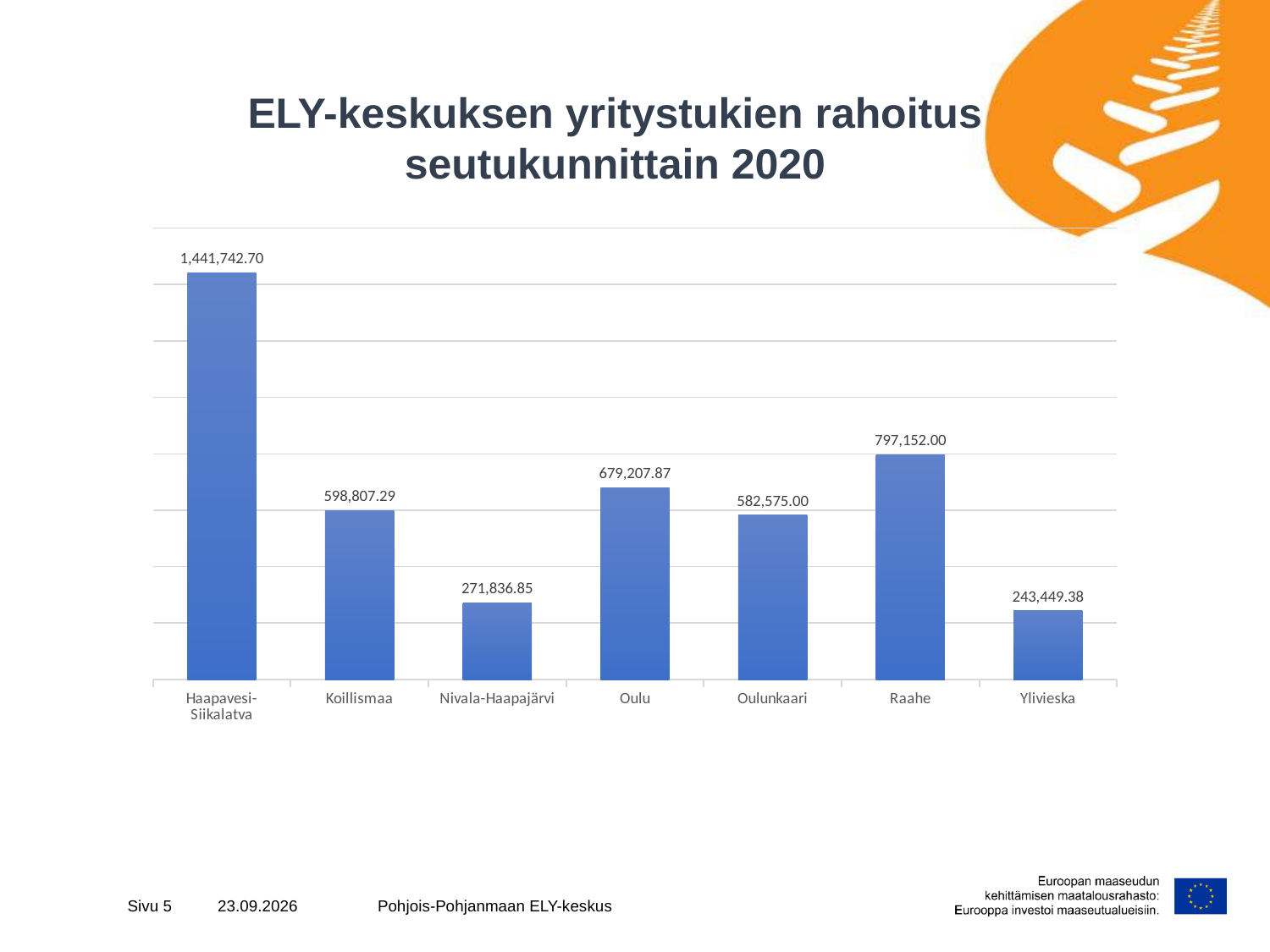
How many categories are shown on the x axis? 7 What is the title of the slide containing the chart? ELY-keskuksen yritystukien rahoitus seutukunnittain 2020 Which is larger, the value for Oulu or the value for Oulunkaari? Oulu What is the value for Oulunkaari? 582,575.00 What is the value for Raahe? 797,152.00 What is the difference between the values for Raahe and Oulu? 117,944.13 What kind of chart is shown on the slide? Bar chart What is the difference between the values for Haapavesi-Siikalatva and Raahe? 644,590.70 Which category has the highest value? Haapavesi-Siikalatva Which category has the lowest value? Ylivieska What is the value for Nivala-Haapajärvi? 271,836.85 What is the difference between the values for Nivala-Haapajärvi and Ylivieska? 28,387.47